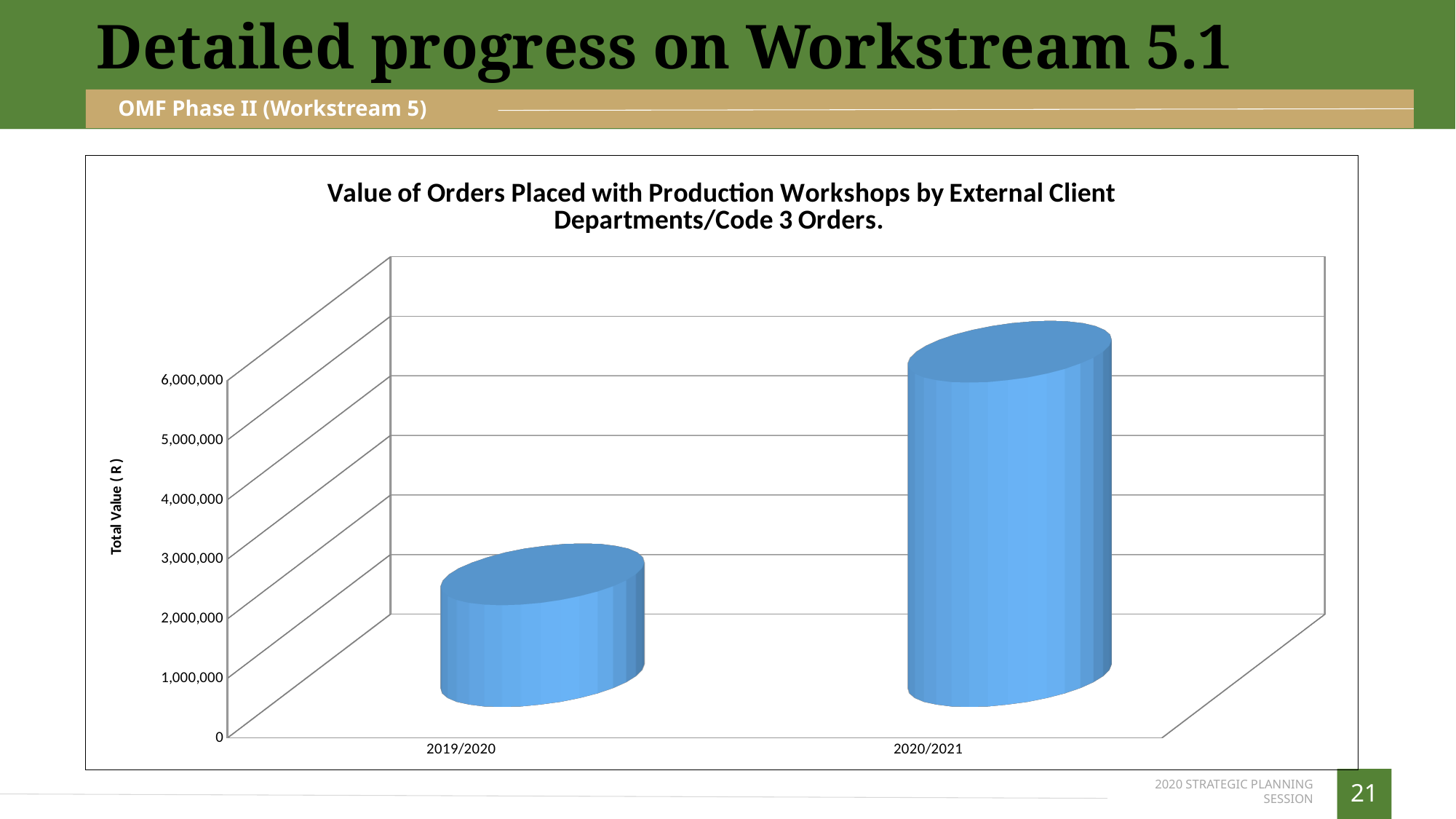
Is the value for 2019/2020 greater or less than 4,000,000? less Is the value for 2020/2021 greater or less than 4,000,000? greater Is the value for 2020/2021 greater or less than 3,000,000? greater Do the values rise or fall from 2019/2020 to 2020/2021? rise What kind of chart is shown on the slide? bar chart Which year has the highest value of orders placed? 2020/2021 Which year has the lowest value of orders placed? 2019/2020 Which is larger, the value for 2019/2020 or the value for 2020/2021? 2020/2021 What is the label on the vertical axis of the chart? Total Value ( R ) How many categories are plotted on the x axis of the chart? 2 What is the title of the chart? Value of Orders Placed with Production Workshops by External Client Departments/Code 3 Orders.